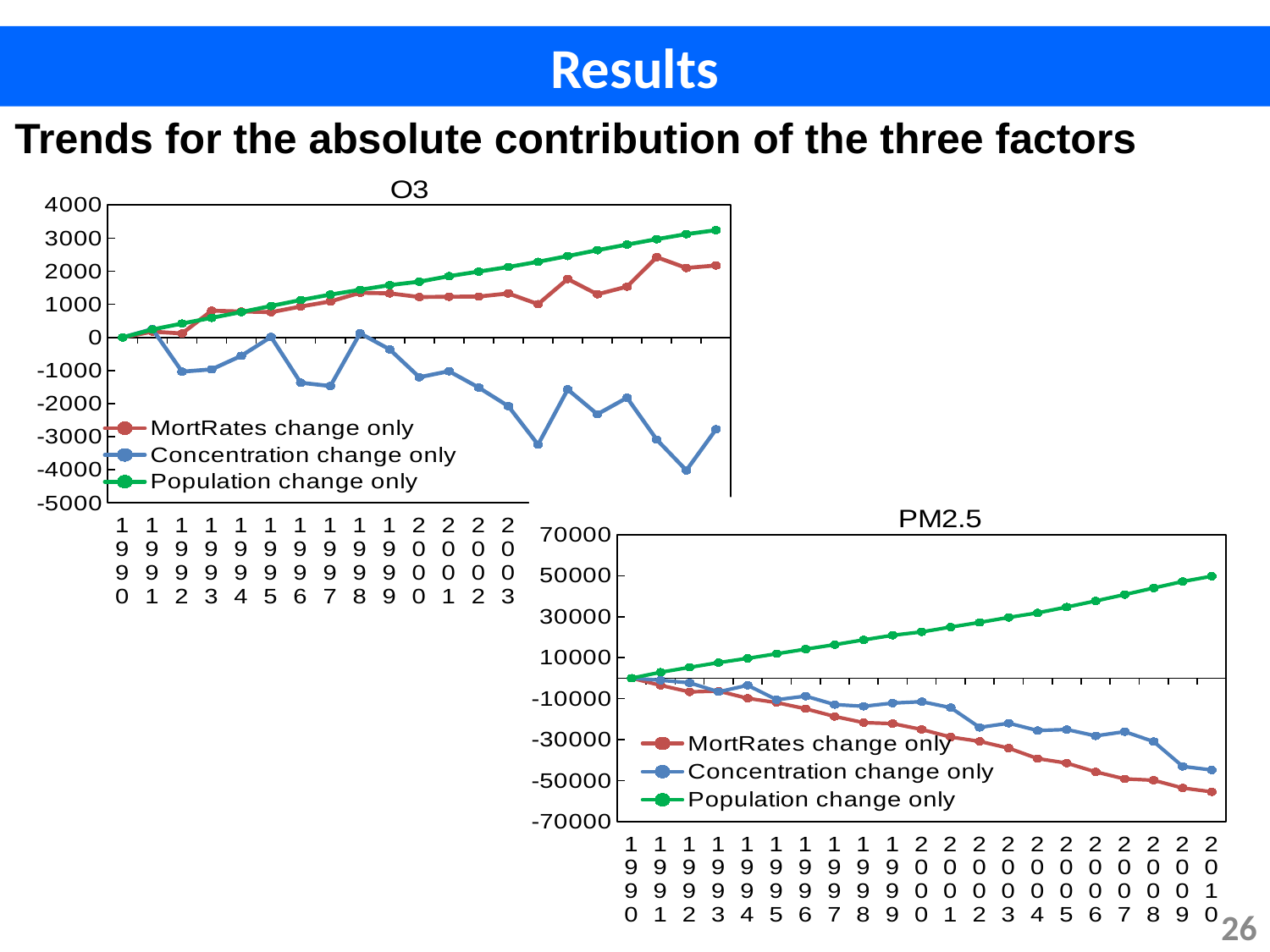
Which series is drawn in green in the PM2.5 chart? Population change only How many series does the legend of the PM2.5 chart list? 3 In the O3 chart, which series has the higher value in 2003, Population change only or MortRates change only? Population change only In the O3 chart, is the value for Concentration change only in 1996 greater or less than -1000? less In the PM2.5 chart, does the MortRates change only series rise or fall from 1990 to 2010? fall In the PM2.5 chart, is the value for Population change only in 2010 greater or less than 30000? greater How many years are shown on the x axis of the PM2.5 chart? 21 In the O3 chart, does the Population change only series rise or fall from 1990 to 2003? rise In the O3 chart, is the value for Population change only in 2003 greater or less than 3000? less What type of chart is the O3 chart? line chart